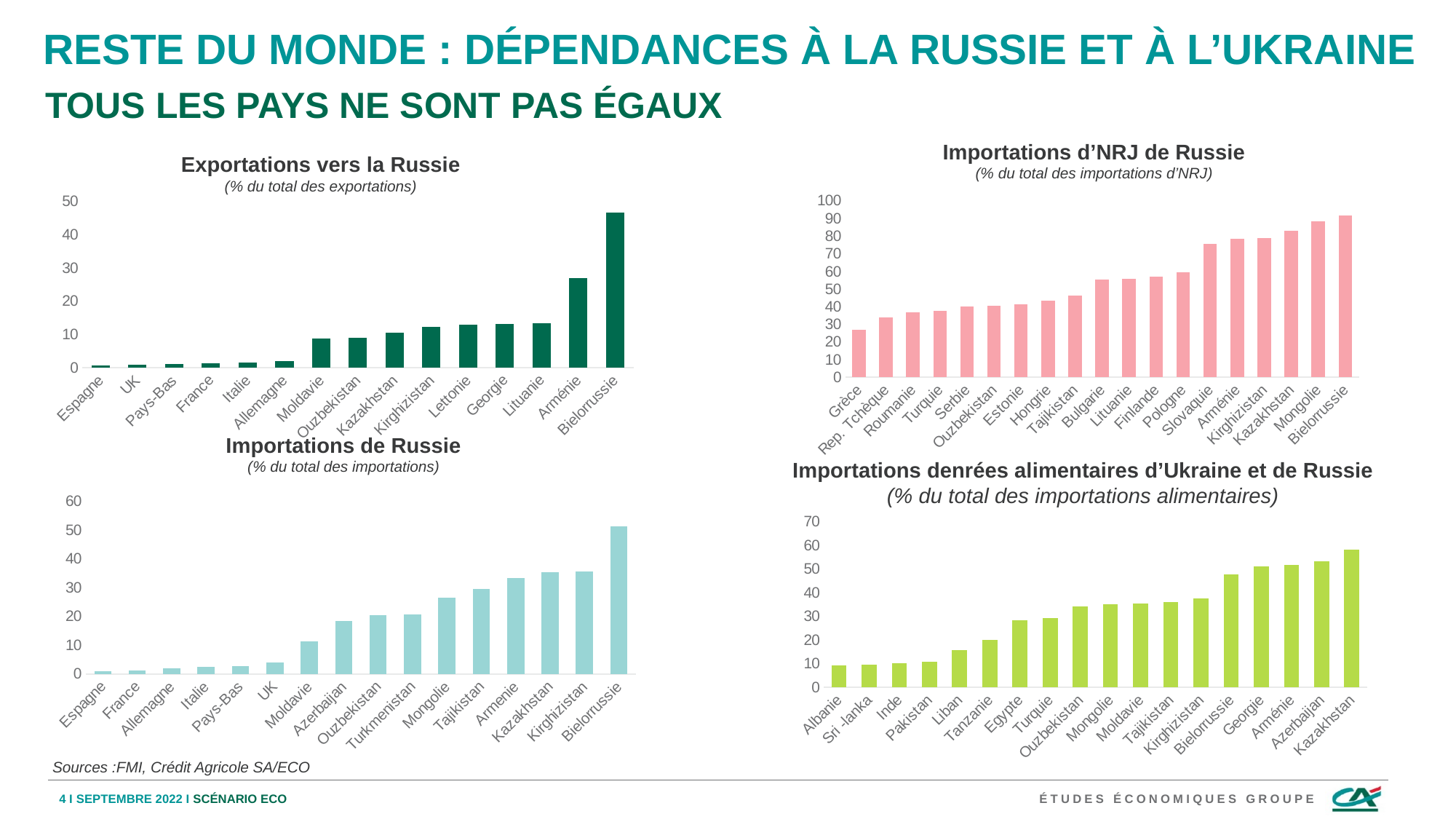
In the 'Exportations vers la Russie' chart, which country has the highest value? Bielorrussie What kind of chart is the 'Importations denrées alimentaires d'Ukraine et de Russie' chart? bar chart In the 'Importations denrées alimentaires d'Ukraine et de Russie' chart, which country has the highest value? Kazakhstan In the 'Exportations vers la Russie' chart, is the value for Arménie greater or less than 20? greater How many countries are shown in the 'Exportations vers la Russie' chart? 15 In the 'Importations de Russie' chart, which is larger, the value for Kazakhstan or the value for Moldavie? Kazakhstan In the 'Importations denrées alimentaires d'Ukraine et de Russie' chart, which is larger, the value for Bielorussie or the value for Egypte? Bielorrussie In the 'Importations d'NRJ de Russie' chart, which country has the lowest value? Grèce In the 'Importations d'NRJ de Russie' chart, is the value for Slovaquie greater or less than 70? greater How many countries are shown in the 'Importations d'NRJ de Russie' chart? 19 In the 'Importations de Russie' chart, which country has the highest value? Bielorrussie In the 'Importations de Russie' chart, is the value for Mongolie greater or less than 20? greater